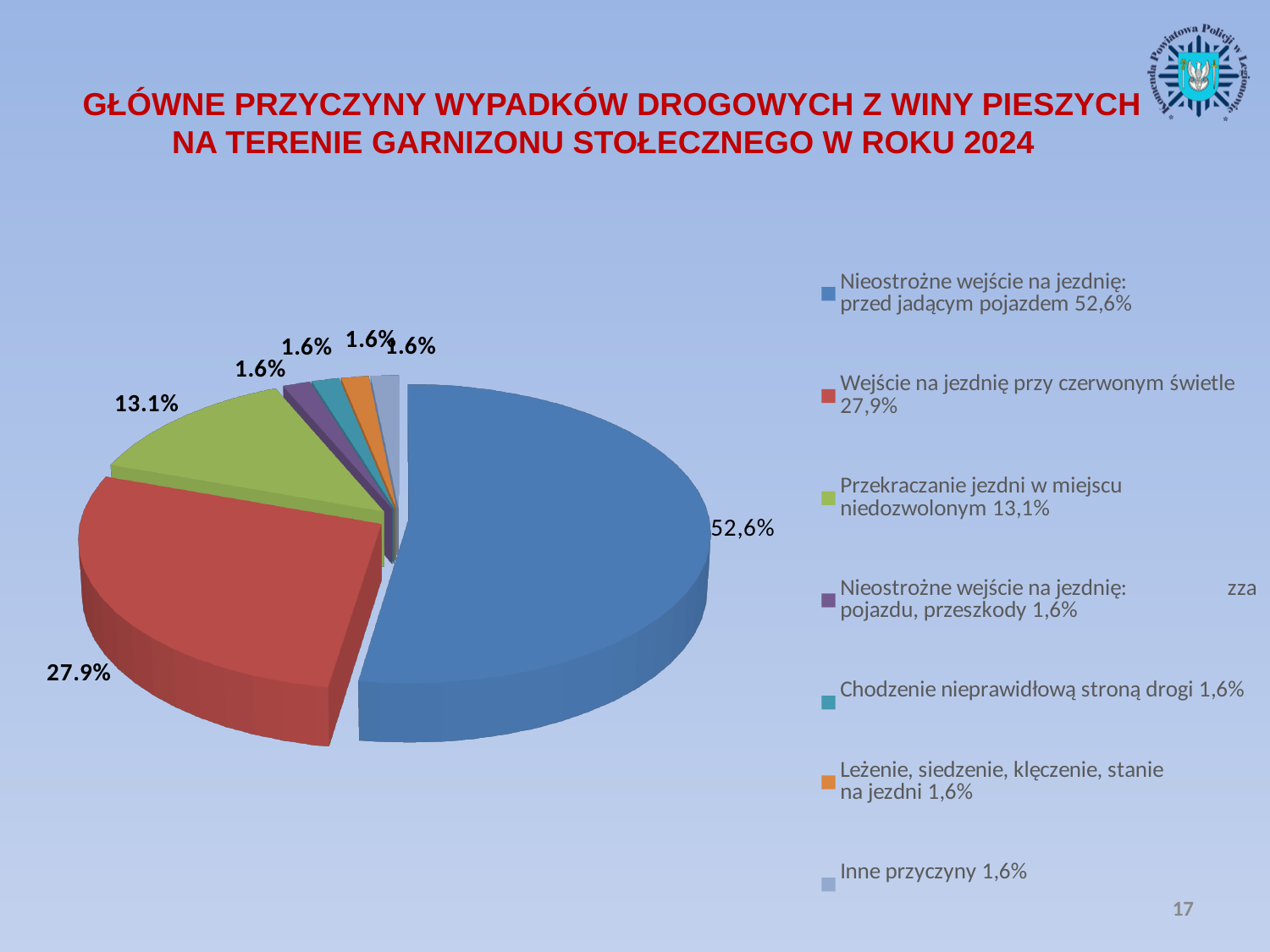
What kind of chart is shown on the slide? pie chart What share of the pie is labelled for 'Przekraczanie jezdni w miejscu niedozwolonym'? 13.1% What year does the chart title refer to? 2024 What is the difference in percentage points between the 'Wejście na jezdnię przy czerwonym świetle' slice (27.9%) and the 'Przekraczanie jezdni w miejscu niedozwolonym' slice (13.1%)? 14.8 What colour is the slice for 'Wejście na jezdnię przy czerwonym świetle'? red Which is larger: the slice for 'Wejście na jezdnię przy czerwonym świetle' or the slice for 'Przekraczanie jezdni w miejscu niedozwolonym'? Wejście na jezdnię przy czerwonym świetle Which category has the largest slice of the pie? Nieostrożne wejście na jezdnię: przed jadącym pojazdem What share of the pie is labelled for 'Wejście na jezdnię przy czerwonym świetle'? 27.9% How many categories in the legend are labelled with 1,6%? 4 What share of the pie is labelled for 'Nieostrożne wejście na jezdnię: przed jadącym pojazdem'? 52,6% How many slices does the pie chart have? 7